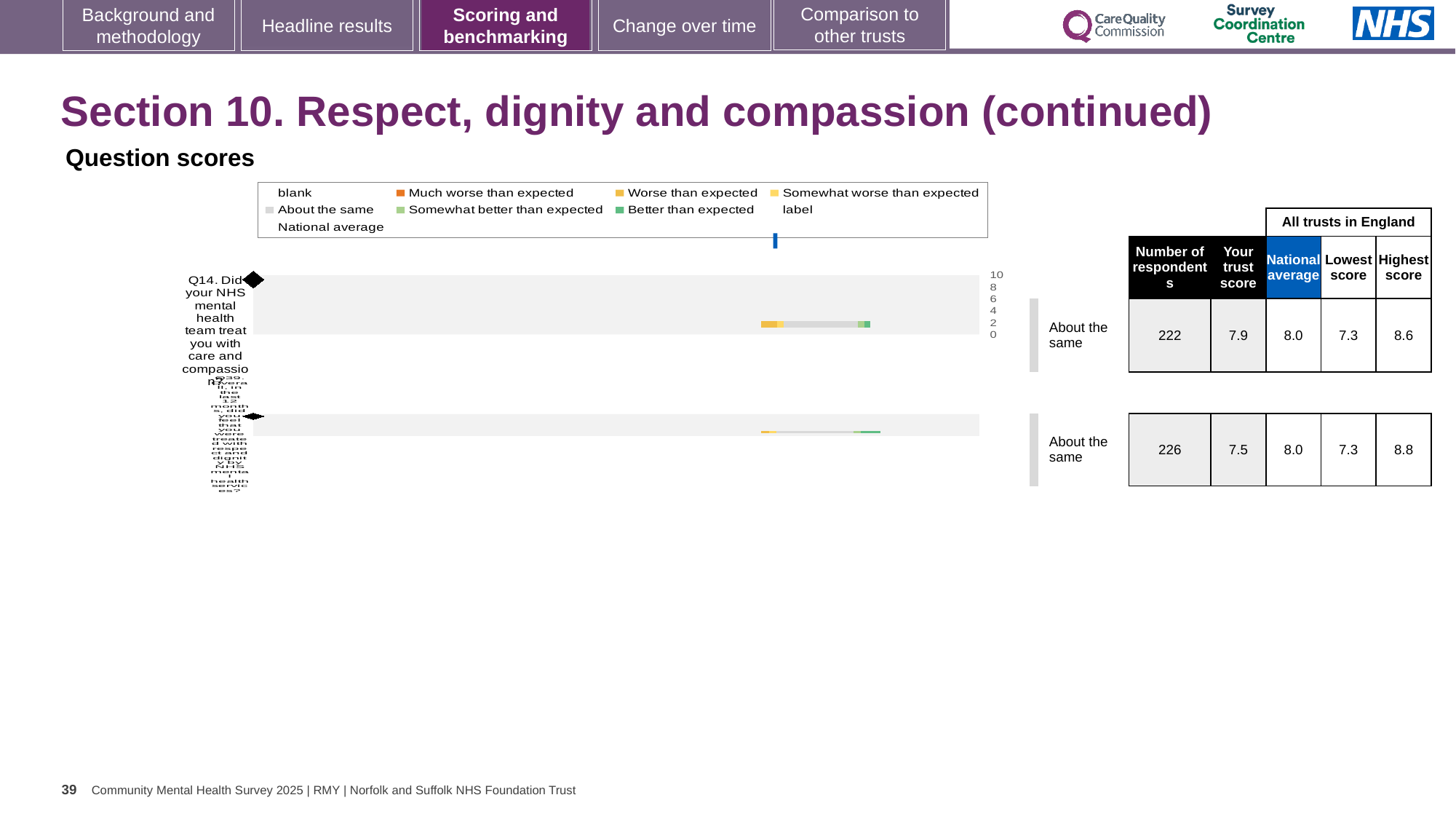
What is the difference between the national average and the trust score for Q14? 0.1 What is the trust's score for Q39 (respect and dignity)? 7.5 What is the number of respondents for Q14 in the question scores table? 222 What is the difference between the highest and lowest scores for Q39? 1.5 What is the national average score for Q14? 8.0 What is the trust's score for Q14 (care and compassion)? 7.9 Is the trust score for Q39 greater or less than 8? less How many survey questions are plotted in the question scores chart? 2 Which question has the higher trust score, Q14 or Q39? Q14 What is the highest score among all trusts in England for Q39? 8.8 What benchmark category is shown for Q14 next to the chart? About the same What kind of chart is used to show the question scores on this slide? bar chart